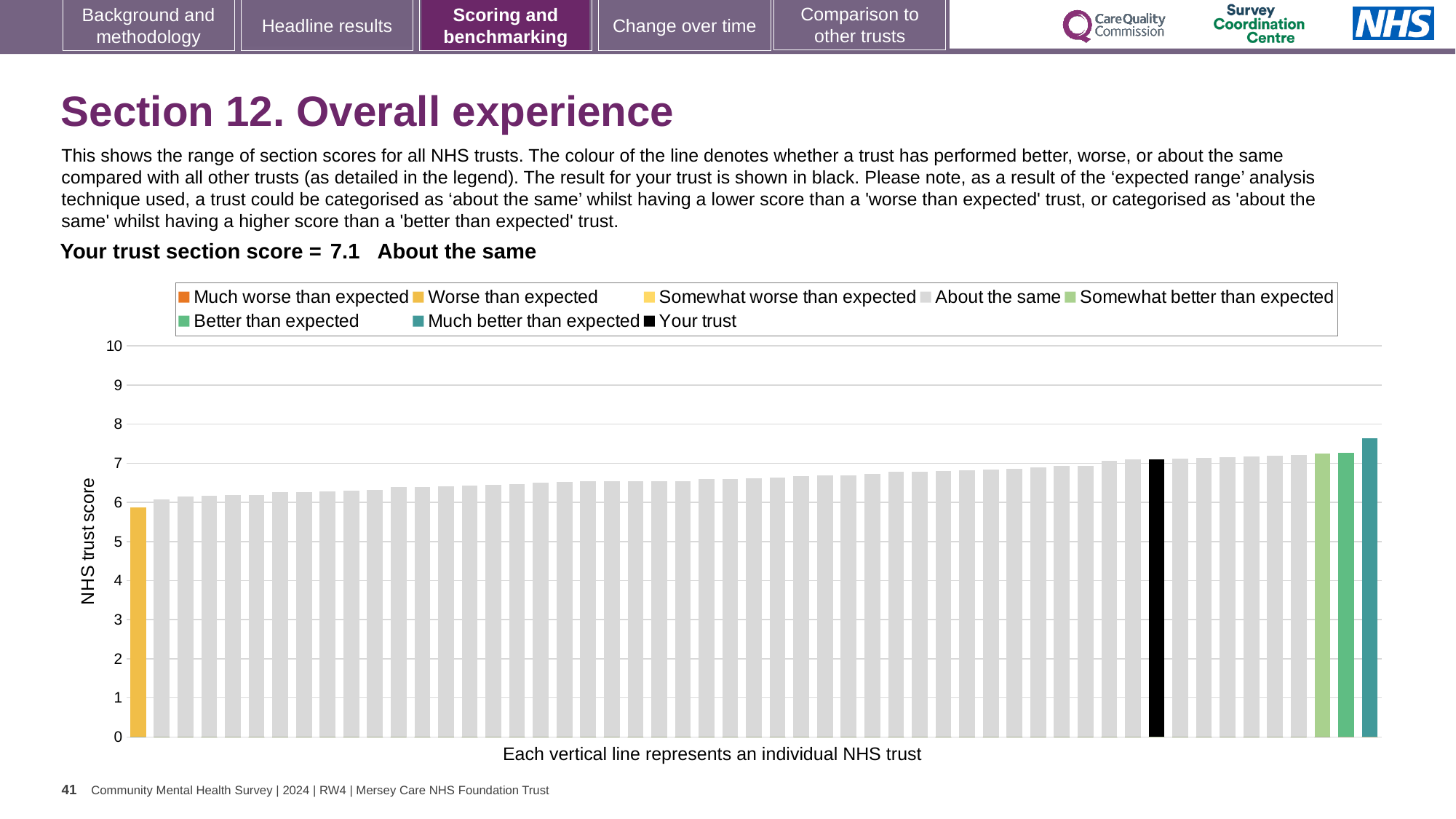
How many bars in the chart are coloured something other than grey? 5 Which performance category is your trust placed in? About the same What colour is the bar representing your trust? black Is the value of the shortest bar (the leftmost, 'Worse than expected' trust) greater or less than 7? less Is the value of the tallest bar (the rightmost, 'Much better than expected' trust) greater or less than 7? greater Do the bar values rise or fall from left to right across the chart? rise What is the label on the vertical axis of the chart? NHS trust score Which is larger: the score for your trust (black bar) or the score of the leftmost yellow bar? your trust What is the section score for your trust shown on the slide? 7.1 What kind of chart is shown on the slide? bar chart How many entries does the chart legend list? 8 Is the value of the tallest bar (the rightmost trust) greater or less than 8? less